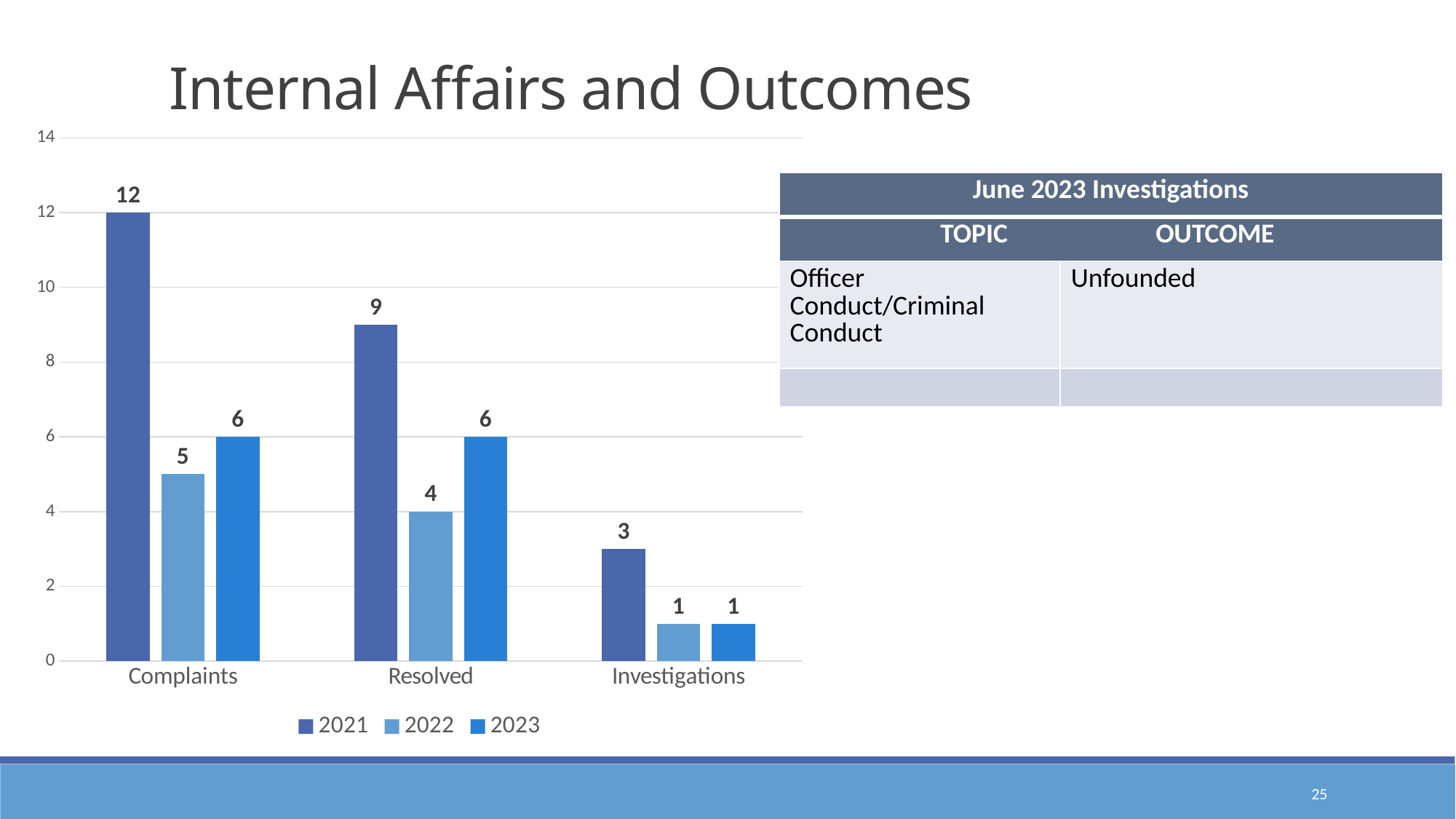
How many series does the chart legend list? 3 What is the difference between the 2021 and 2023 values for Complaints? 6 Which category has the lowest value for the 2022 series? Investigations Is the 2021 value for Resolved greater or less than 8? greater What is the value for Resolved in 2022? 4 How many categories are shown on the x axis of the chart? 3 What is the value for Investigations in 2023? 1 Which category has the highest value for the 2021 series? Complaints Which is larger, the 2022 value for Complaints or the 2022 value for Resolved? 2022 value for Complaints What kind of chart is shown on the slide? bar chart What are the series names listed in the chart legend? 2021, 2022, 2023 What is the value for Complaints in 2021? 12